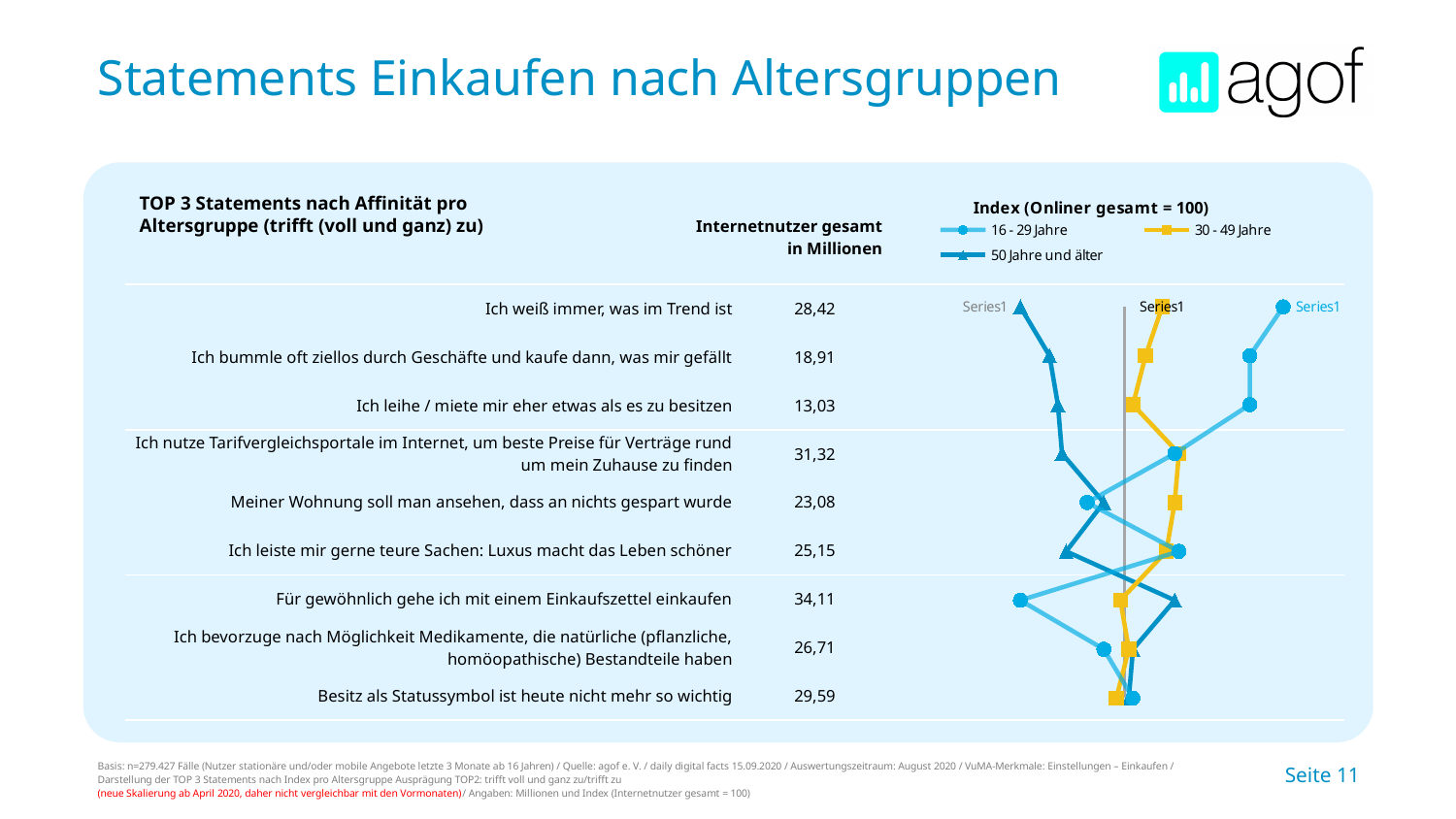
Is the index value for 16 - 29 Jahre for the statement "Für gewöhnlich gehe ich mit einem Einkaufszettel einkaufen" greater or less than 100? less Which statement has the lowest value of Internetnutzer gesamt in Millionen? Ich leihe / miete mir eher etwas als es zu besitzen What is the value of Internetnutzer gesamt in Millionen for the statement "Für gewöhnlich gehe ich mit einem Einkaufszettel einkaufen"? 34,11 What kind of chart is shown on the slide? line chart Which age groups are listed in the chart legend? 16 - 29 Jahre, 30 - 49 Jahre, 50 Jahre und älter Is the index value for 50 Jahre und älter for the statement "Ich weiß immer, was im Trend ist" greater or less than 100? less For the statement "Ich weiß immer, was im Trend ist", which age group has the highest index? 16 - 29 Jahre How many statements are plotted in the chart? 9 Is the index value for 16 - 29 Jahre for the statement "Ich weiß immer, was im Trend ist" greater or less than 100? greater How many series does the chart legend list? 3 For the statement "Für gewöhnlich gehe ich mit einem Einkaufszettel einkaufen", which has the higher index: 16 - 29 Jahre or 50 Jahre und älter? 50 Jahre und älter Which statement has the highest value of Internetnutzer gesamt in Millionen? Für gewöhnlich gehe ich mit einem Einkaufszettel einkaufen